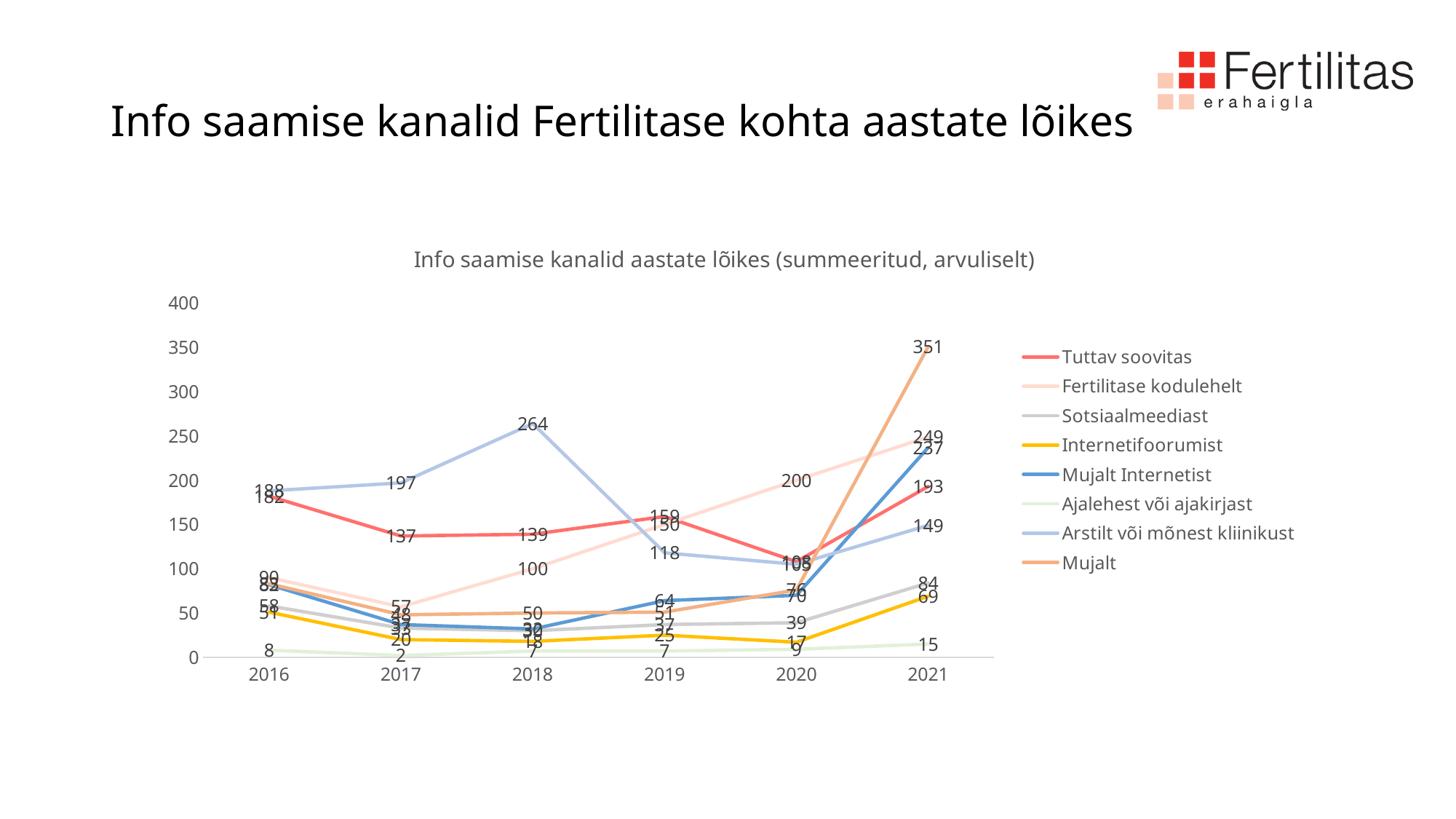
Which series has the highest value in 2021? Mujalt What is the value for Ajalehest või ajakirjast in 2017? 2 Which series has the lowest value in 2021? Ajalehest või ajakirjast What is the value for Arstilt või mõnest kliinikust in 2018? 264 What is the value for Tuttav soovitas in 2017? 137 What kind of chart is shown on the slide? Line chart What is the value for Fertilitase kodulehelt in 2021? 249 What is the value for Mujalt in 2021? 351 In 2018, which is larger: Arstilt või mõnest kliinikust or Tuttav soovitas? Arstilt või mõnest kliinikust How many years are shown on the x axis? 6 How many series does the legend list? 8 What is the difference between Mujalt and Fertilitase kodulehelt in 2021? 102